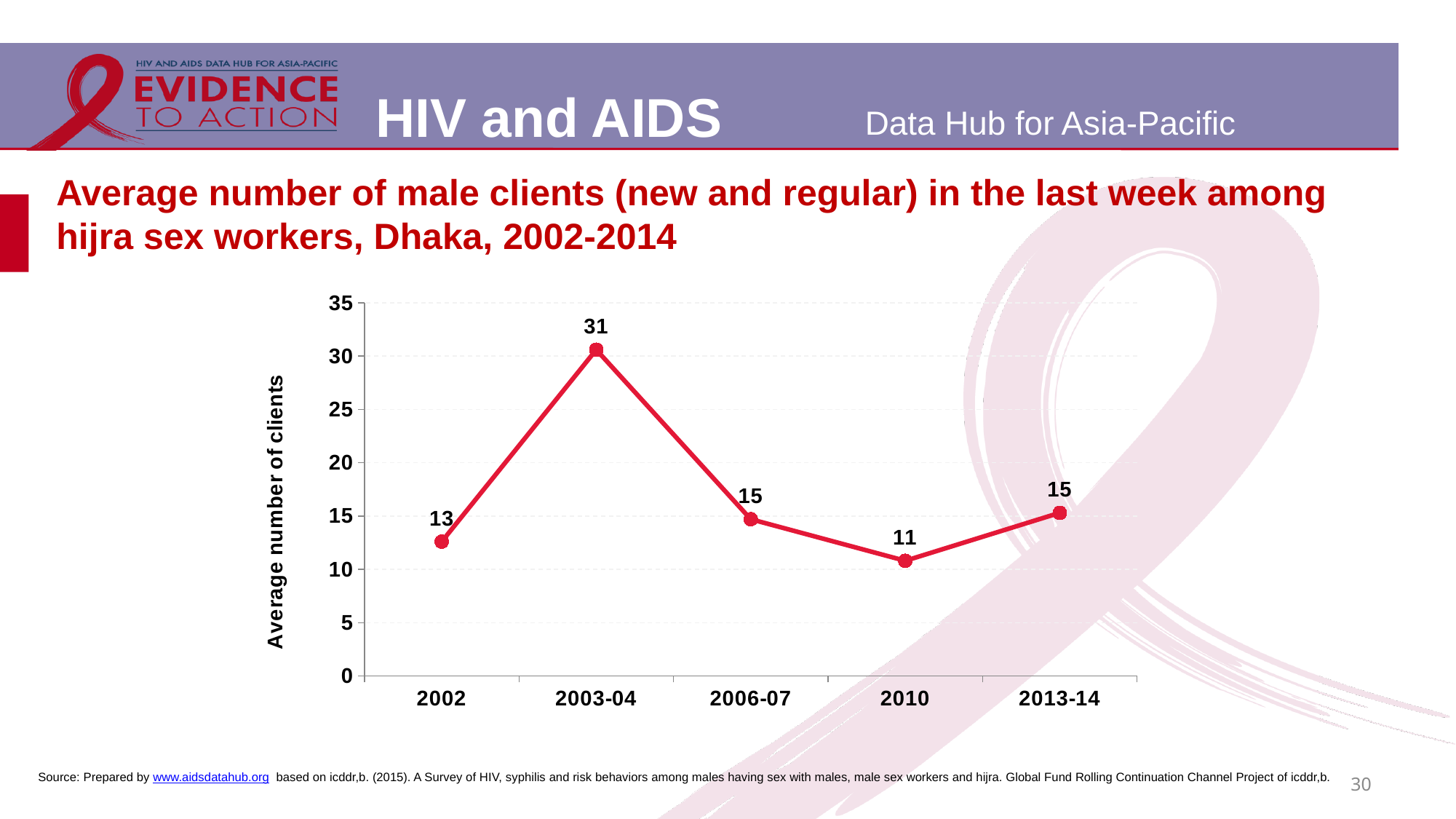
Which period has the lowest average number of clients? 2010 Is the value for 2003-04 greater or less than 30? greater What kind of chart is shown on the slide? Line chart Which period has the highest average number of clients? 2003-04 What is the average number of clients shown for 2010? 11 What is the difference between the average number of clients in 2003-04 and in 2010? 20 What is the label of the vertical axis? Average number of clients What is the average number of male clients in the last week among hijra sex workers in Dhaka in 2002? 13 What is the difference between the average number of clients in 2013-14 and in 2002? 2 What is the average number of clients shown for 2003-04? 31 How many time periods are plotted on the chart? 5 Which is larger, the average number of clients in 2002 or in 2006-07? 2006-07